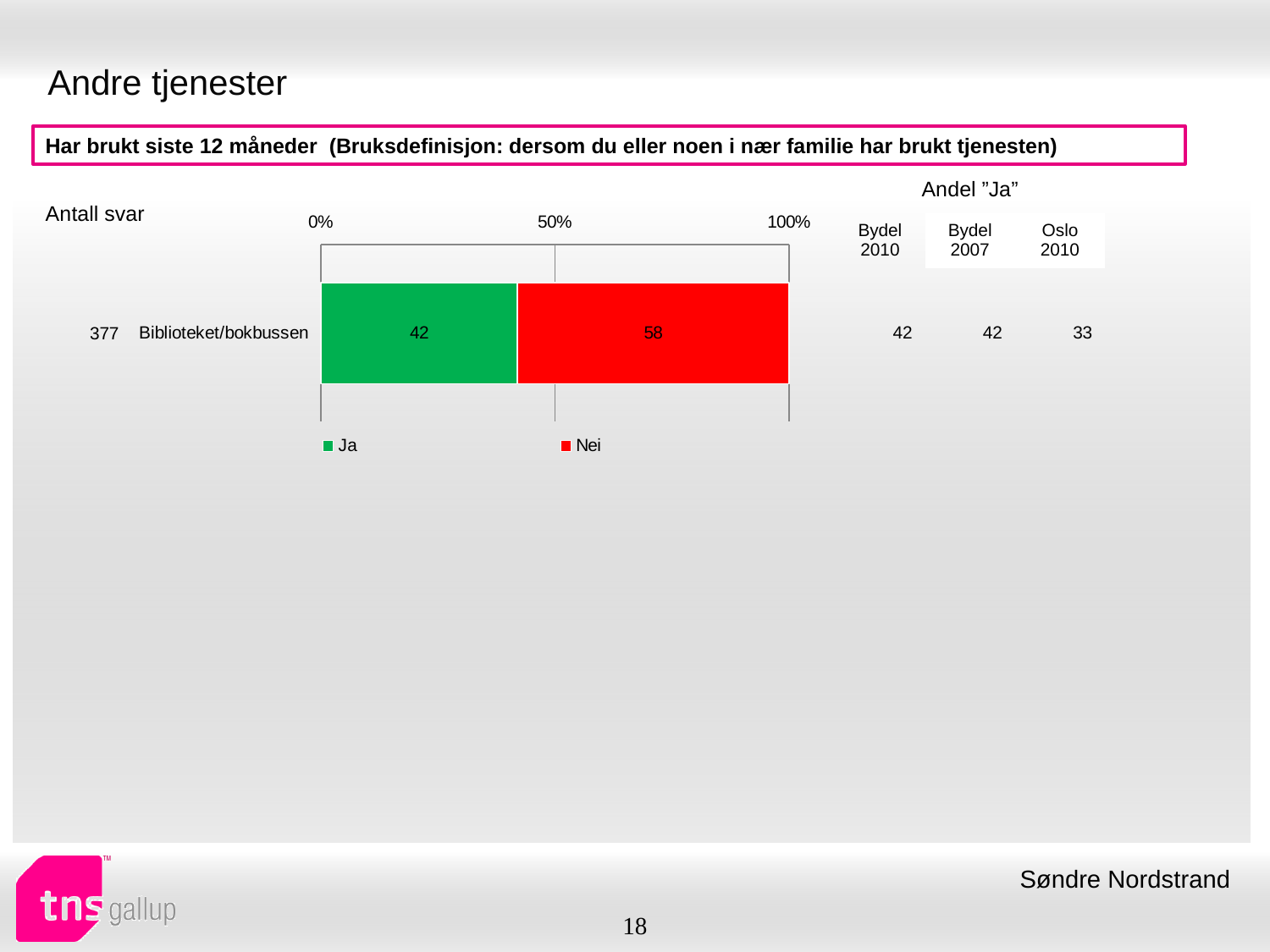
What is the total of the stacked bar for Biblioteket/bokbussen? 100 What is the value for "Ja" for Biblioteket/bokbussen? 42 How many categories are plotted in the chart? 1 Is the "Ja" value for Biblioteket/bokbussen greater or less than 50%? less What colour represents "Ja" in the chart? Green What is the number of responses (Antall svar) for Biblioteket/bokbussen? 377 What is the value for "Nei" for Biblioteket/bokbussen? 58 What kind of chart is shown on the slide? Stacked bar chart What is the difference between the "Nei" and "Ja" values for Biblioteket/bokbussen? 16 Which is larger for Biblioteket/bokbussen, "Ja" or "Nei"? Nei How many series does the legend list? 2 Is the "Nei" value for Biblioteket/bokbussen greater or less than 50%? greater